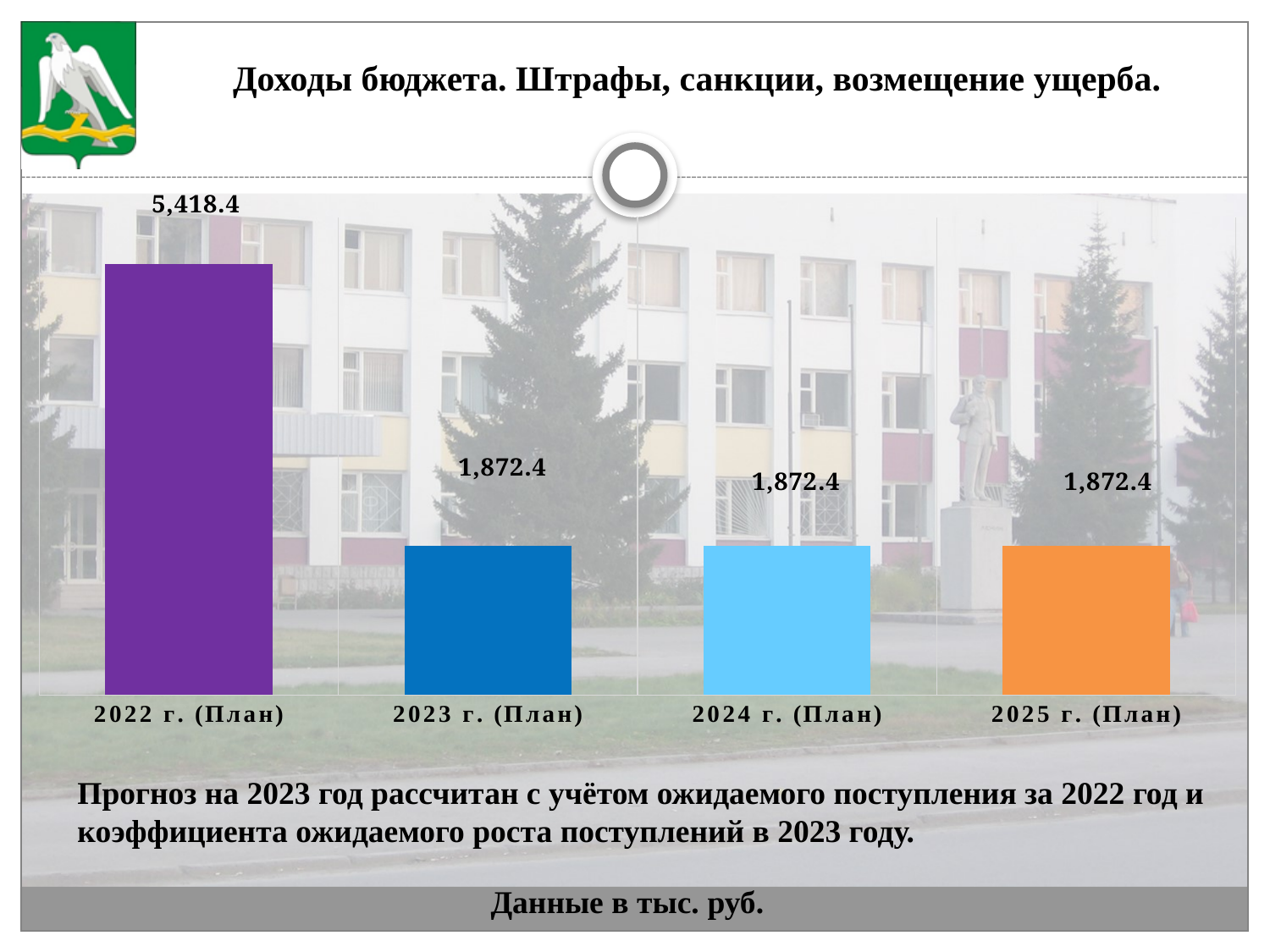
What is the title of the chart? Доходы бюджета. Штрафы, санкции, возмещение ущерба. What kind of chart is shown on the slide? Bar chart What is the value for 2025 г. (План)? 1,872.4 What is the difference between the values for 2022 г. (План) and 2023 г. (План)? 3,546.0 Which category has the highest value? 2022 г. (План) What is the value for 2024 г. (План)? 1,872.4 What is the value for 2023 г. (План)? 1,872.4 What is the value for 2022 г. (План)? 5,418.4 Which is larger, the value for 2022 г. (План) or the value for 2025 г. (План)? 2022 г. (План) What colour is the bar for 2025 г. (План)? Orange Do the values rise or fall from 2022 г. (План) to 2023 г. (План)? Fall How many categories are shown on the chart? 4